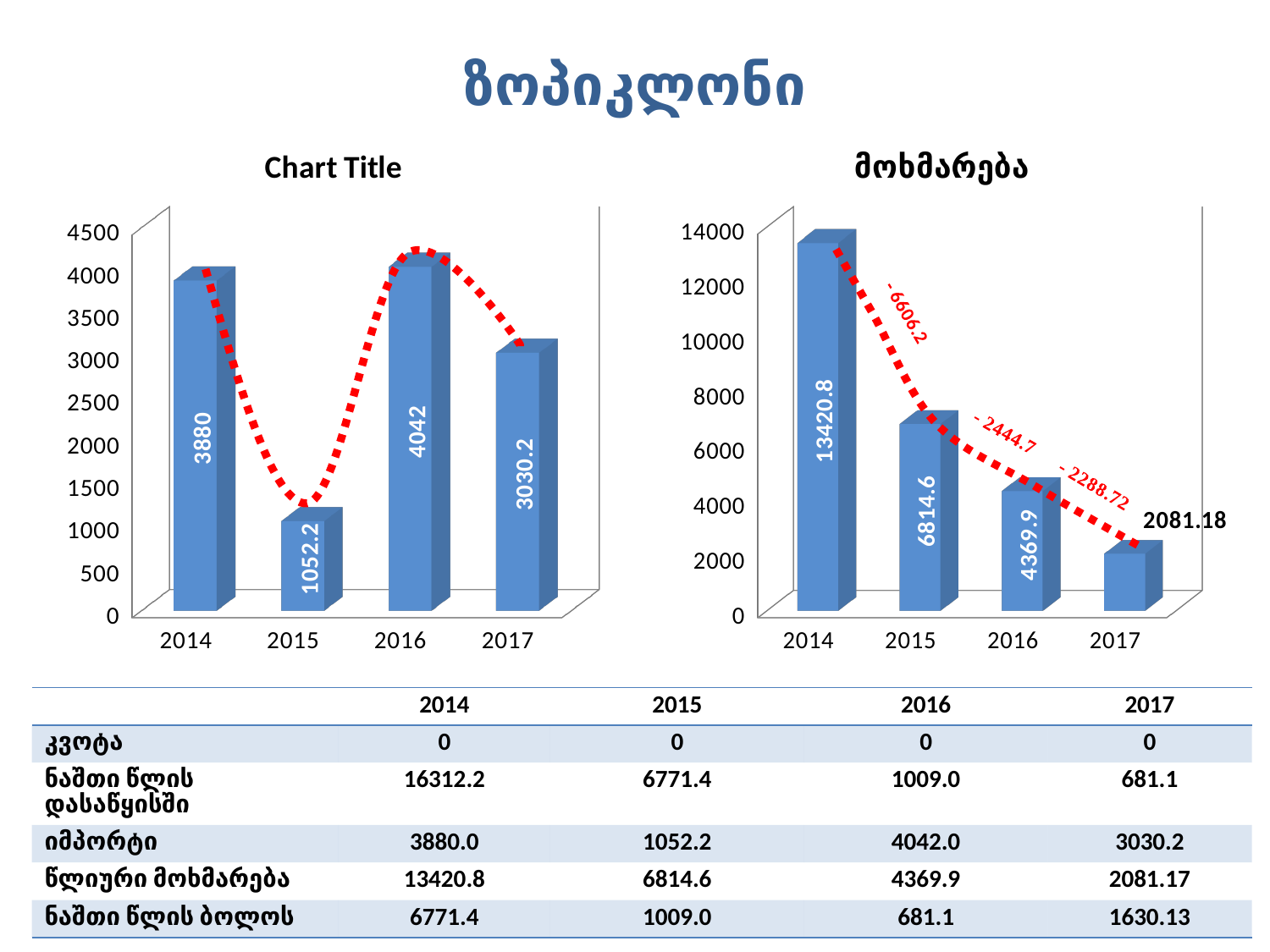
In the right chart titled "მოხმარება", what is the value for 2017? 2081.18 In the right chart titled "მოხმარება", do the values rise or fall from 2014 to 2017? fall In the left chart titled "Chart Title", is the value for 2017 greater or less than 3500? less In the left chart titled "Chart Title", what is the difference between the values for 2016 and 2014? 162 What kind of chart is the left chart titled "Chart Title"? bar chart In the right chart titled "მოხმარება", what is the difference between the values for 2015 and 2016? 2444.7 In the right chart titled "მოხმარება", what is the value for 2014? 13420.8 How many years are shown on the x axis of the right chart titled "მოხმარება"? 4 In the left chart titled "Chart Title", which year has the highest value? 2016 In the right chart titled "მოხმარება", which is larger, the value for 2015 or the value for 2016? 2015 In the left chart titled "Chart Title", which year has the lowest value? 2015 In the left chart titled "Chart Title", what is the value for 2015? 1052.2